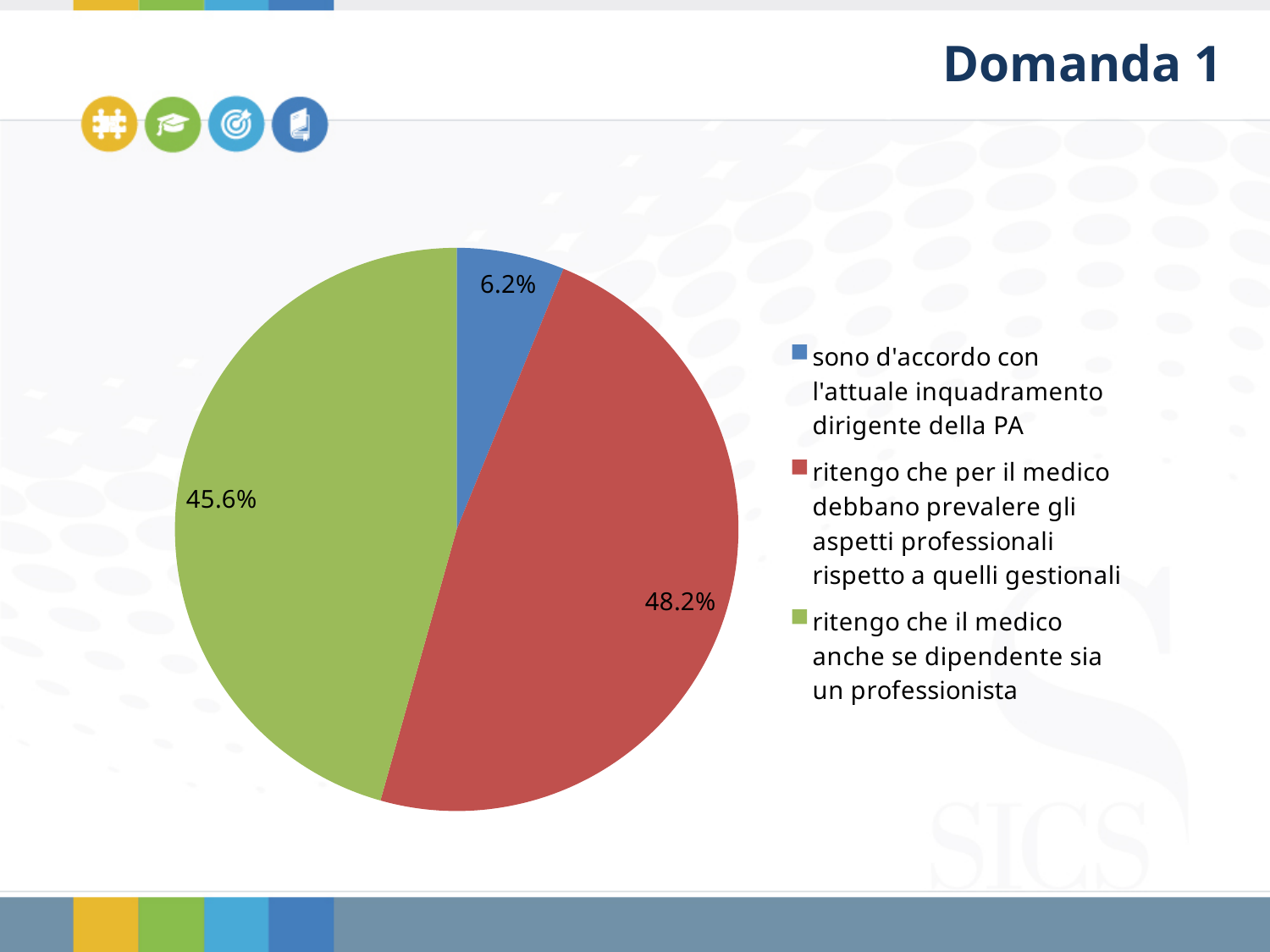
What is the title of the slide containing the pie chart? Domanda 1 What is the difference in percentage points between the "ritengo che il medico anche se dipendente sia un professionista" slice and the "sono d'accordo con l'attuale inquadramento dirigente della PA" slice? 39.4 What share of the pie corresponds to "sono d'accordo con l'attuale inquadramento dirigente della PA"? 6.2% What share of the pie corresponds to "ritengo che per il medico debbano prevalere gli aspetti professionali rispetto a quelli gestionali"? 48.2% Which category has the largest slice of the pie? ritengo che per il medico debbano prevalere gli aspetti professionali rispetto a quelli gestionali How many slices does the pie chart have? 3 Which is larger: the slice for "ritengo che il medico anche se dipendente sia un professionista" or the slice for "ritengo che per il medico debbano prevalere gli aspetti professionali rispetto a quelli gestionali"? ritengo che per il medico debbano prevalere gli aspetti professionali rispetto a quelli gestionali What kind of chart is shown on the slide? pie chart What colour is the slice labelled 6.2%? blue What share of the pie corresponds to "ritengo che il medico anche se dipendente sia un professionista"? 45.6% What is the difference in percentage points between the 48.2% slice and the 45.6% slice? 2.6 Which category has the smallest slice of the pie? sono d'accordo con l'attuale inquadramento dirigente della PA